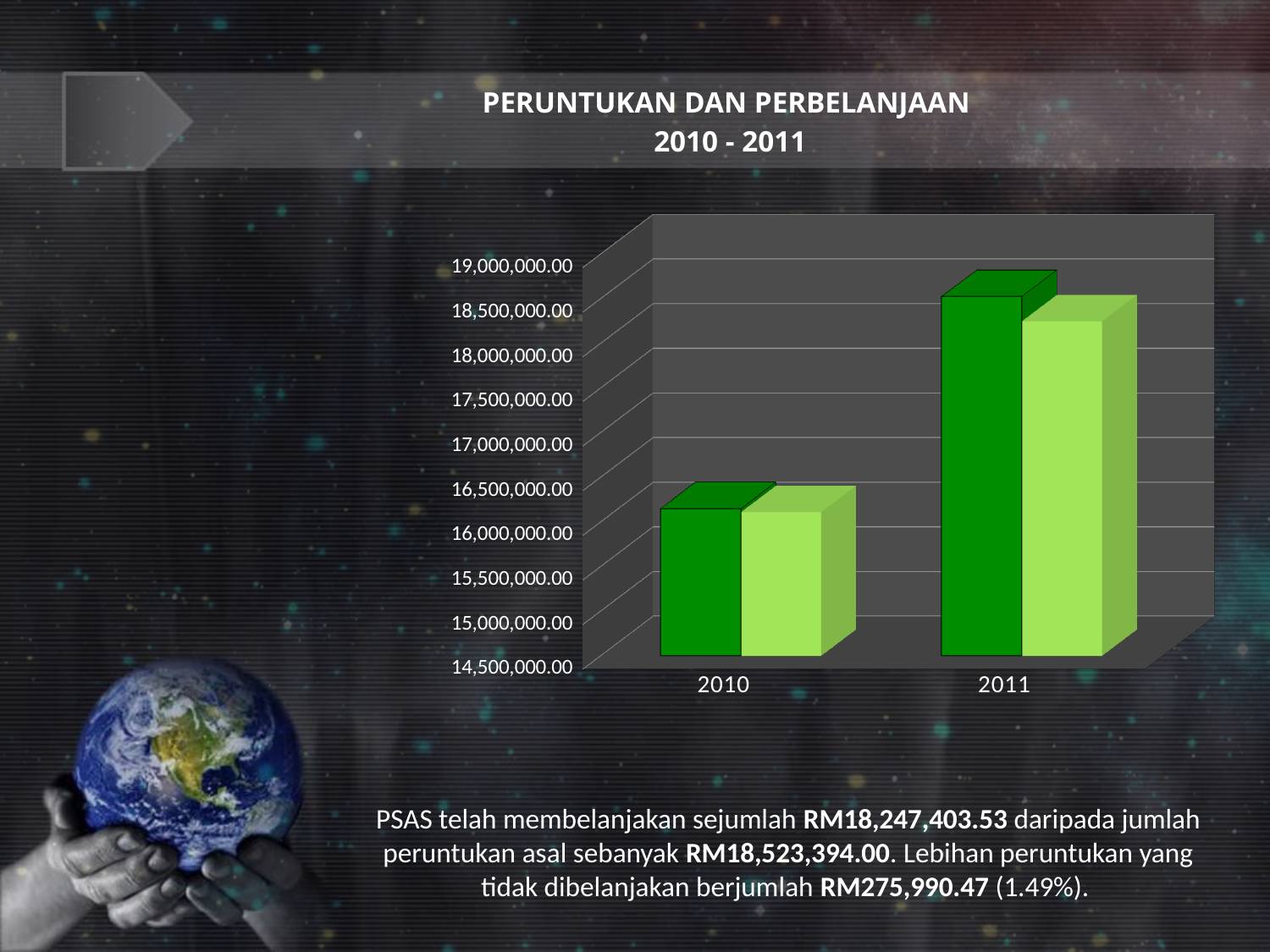
What is the title of the chart? PERUNTUKAN DAN PERBELANJAAN 2010 - 2011 What is the highest value shown on the chart's vertical axis? 19,000,000.00 Do the bar values rise or fall from 2010 to 2011? rise Is the value of the light green bar for 2011 greater or less than 17,500,000.00? greater Is the value of the dark green bar for 2010 greater or less than 17,000,000.00? less Is the value of the dark green bar for 2011 greater or less than 18,000,000.00? greater Which year has the taller dark green bar, 2010 or 2011? 2011 In 2011, which bar is taller, the dark green bar or the light green bar? dark green How many bars are plotted for the year 2010? 2 How many categories are shown on the x axis of the chart? 2 What kind of chart is shown on the slide? bar chart